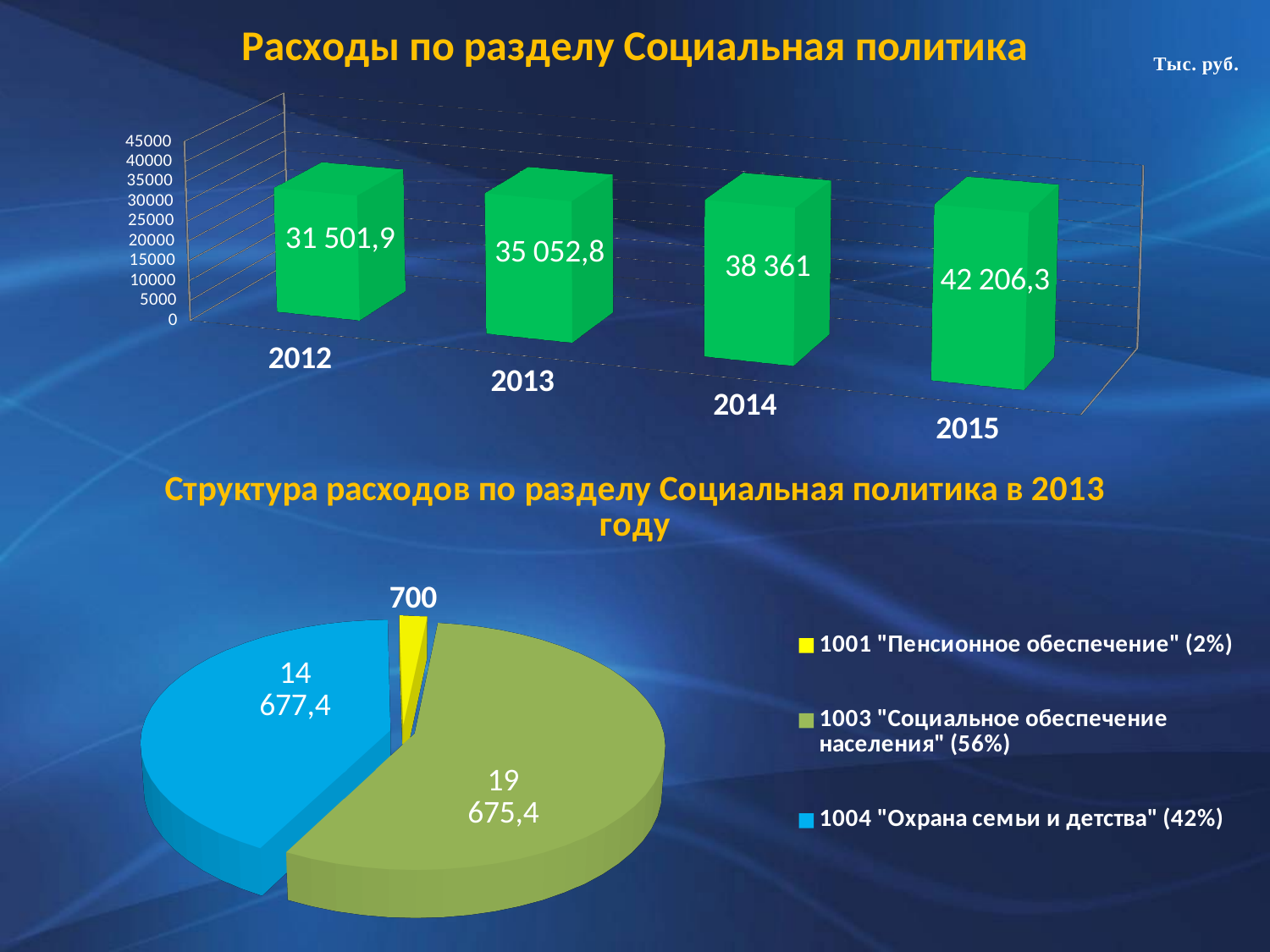
In the pie chart "Структура расходов по разделу Социальная политика в 2013 году", which category has the smallest slice? 1001 "Пенсионное обеспечение" In the chart "Расходы по разделу Социальная политика", what is the value for 2012? 31 501,9 In the pie chart "Структура расходов по разделу Социальная политика в 2013 году", what is the value for 1004 "Охрана семьи и детства"? 14 677,4 In the chart "Расходы по разделу Социальная политика", how many years are shown? 4 In the chart "Расходы по разделу Социальная политика", what is the value for 2014? 38 361 What kind of chart is "Расходы по разделу Социальная политика"? bar chart In the chart "Расходы по разделу Социальная политика", which year has the highest value? 2015 In the chart "Расходы по разделу Социальная политика", what is the difference between the values for 2015 and 2012? 10 704,4 In the pie chart "Структура расходов по разделу Социальная политика в 2013 году", what share does 1003 "Социальное обеспечение населения" have? 56% In the chart "Расходы по разделу Социальная политика", do the values rise or fall from 2012 to 2015? rise In the chart "Расходы по разделу Социальная политика", which year has the lowest value? 2012 In the pie chart "Структура расходов по разделу Социальная политика в 2013 году", what colour is the slice for 1001 "Пенсионное обеспечение"? yellow